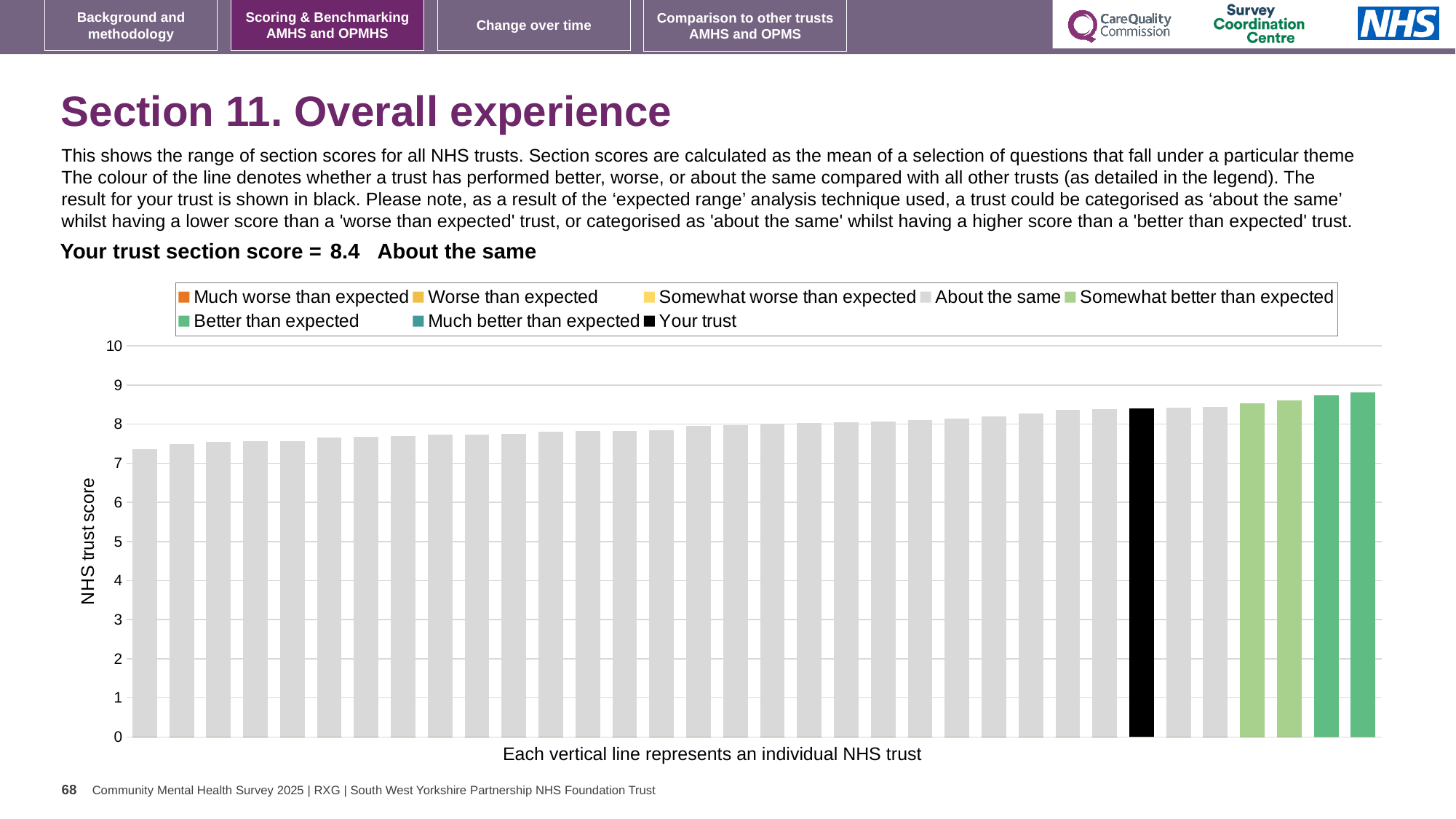
Is the value of the rightmost (highest) bar greater or less than 9? less Is the value of the leftmost (lowest) bar greater or less than 8? less Which benchmarking category is your trust placed in for this section? About the same What is the highest value shown on the vertical axis? 10 Is the value of the leftmost (lowest) bar greater or less than 7? greater What colour is the bar representing your trust? black What is the label on the vertical axis of the chart? NHS trust score What type of chart is shown on the slide? bar chart What is the section score for your trust shown on the slide? 8.4 Do the bar values rise or fall from left to right across the chart? rise How many entries does the chart legend list? 8